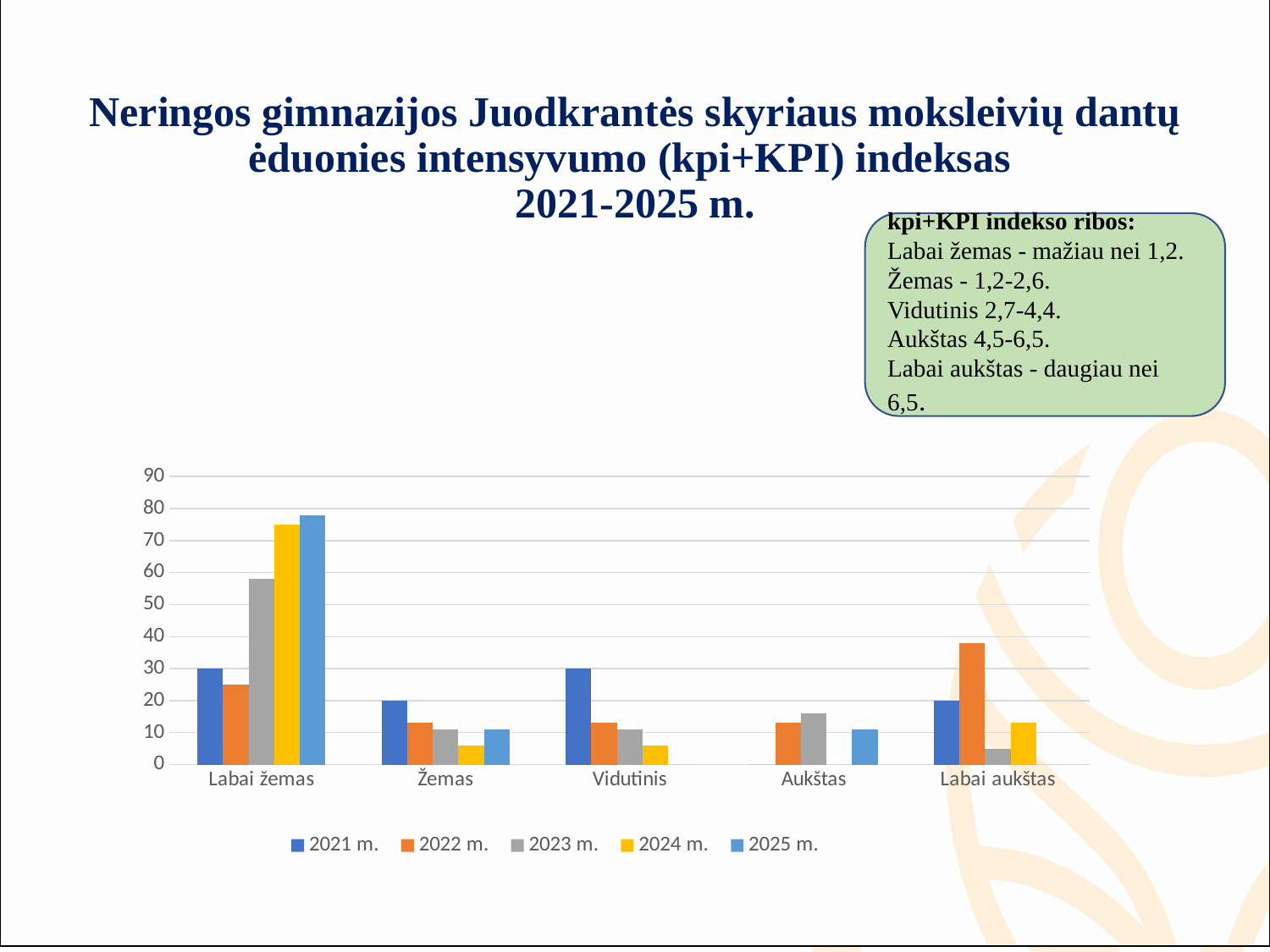
Which year is listed first in the chart legend? 2021 m. In the 'Labai žemas' category, which year has the highest bar? 2025 m. How many series does the legend list? 5 What kind of chart is shown on the slide? bar chart Is the value for 2022 m. in the 'Labai aukštas' category greater or less than 30? greater Is the value for 2023 m. in the 'Labai žemas' category greater or less than 50? greater How many categories are shown on the x axis? 5 In the 'Labai aukštas' category, which is larger: the value for 2021 m. or 2022 m.? 2022 m. Is the value for 2024 m. in the 'Labai žemas' category greater or less than 70? greater